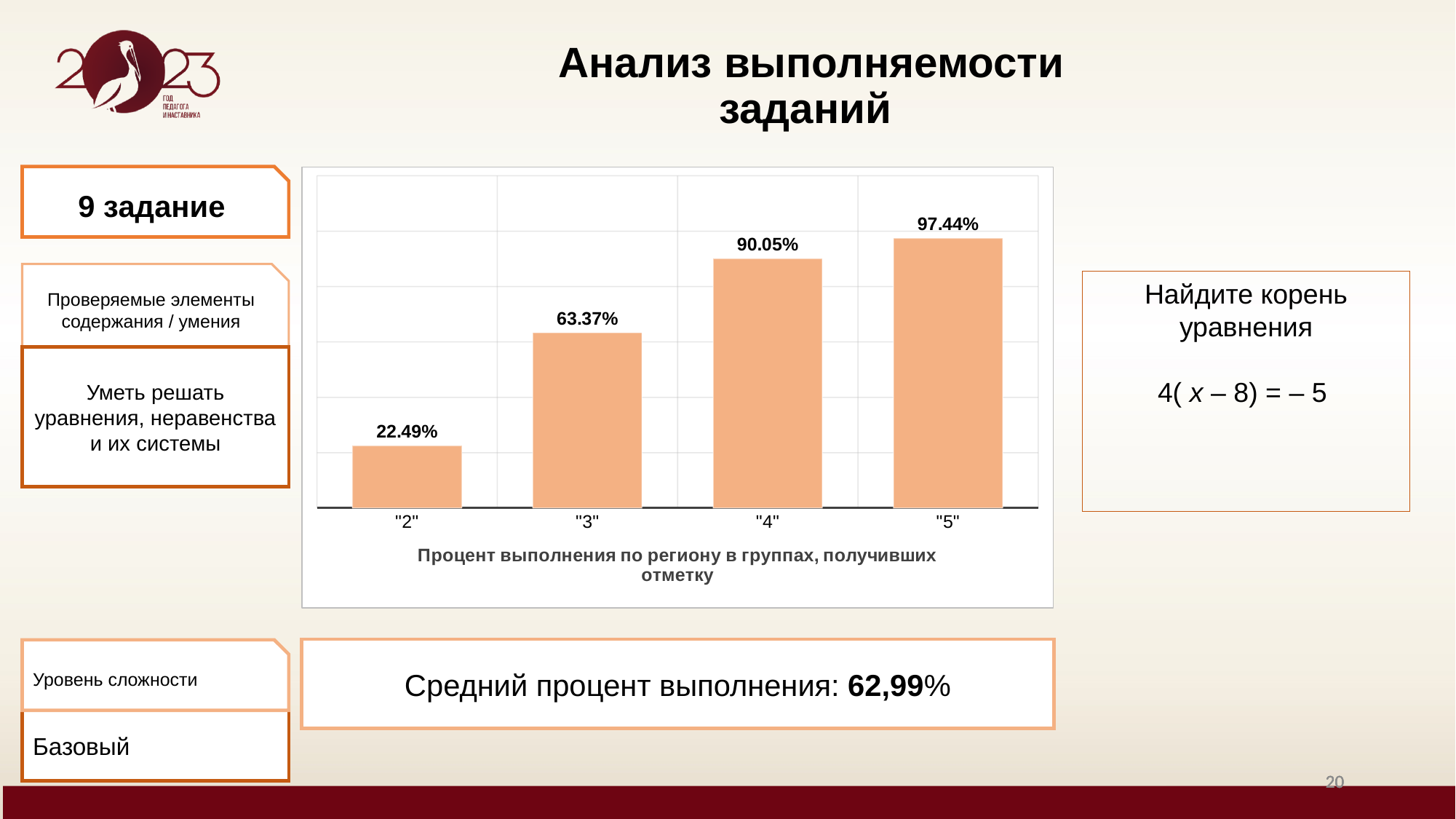
What kind of chart is shown on the slide? Bar chart What is the difference between the values for the "5" and "4" groups? 7.39% What is the value for the "3" group in the chart? 63.37% What is the value for the "2" group in the chart? 22.49% Which is larger, the value for the "3" group or the "4" group? "4" What is the value for the "5" group in the chart? 97.44% Which group has the highest value in the chart? "5" How many groups (bars) are shown in the chart? 4 Do the values rise or fall from the "2" group to the "5" group? Rise What is the value for the "4" group in the chart? 90.05% What is the difference between the values for the "3" and "2" groups? 40.88% Which group has the lowest value in the chart? "2"